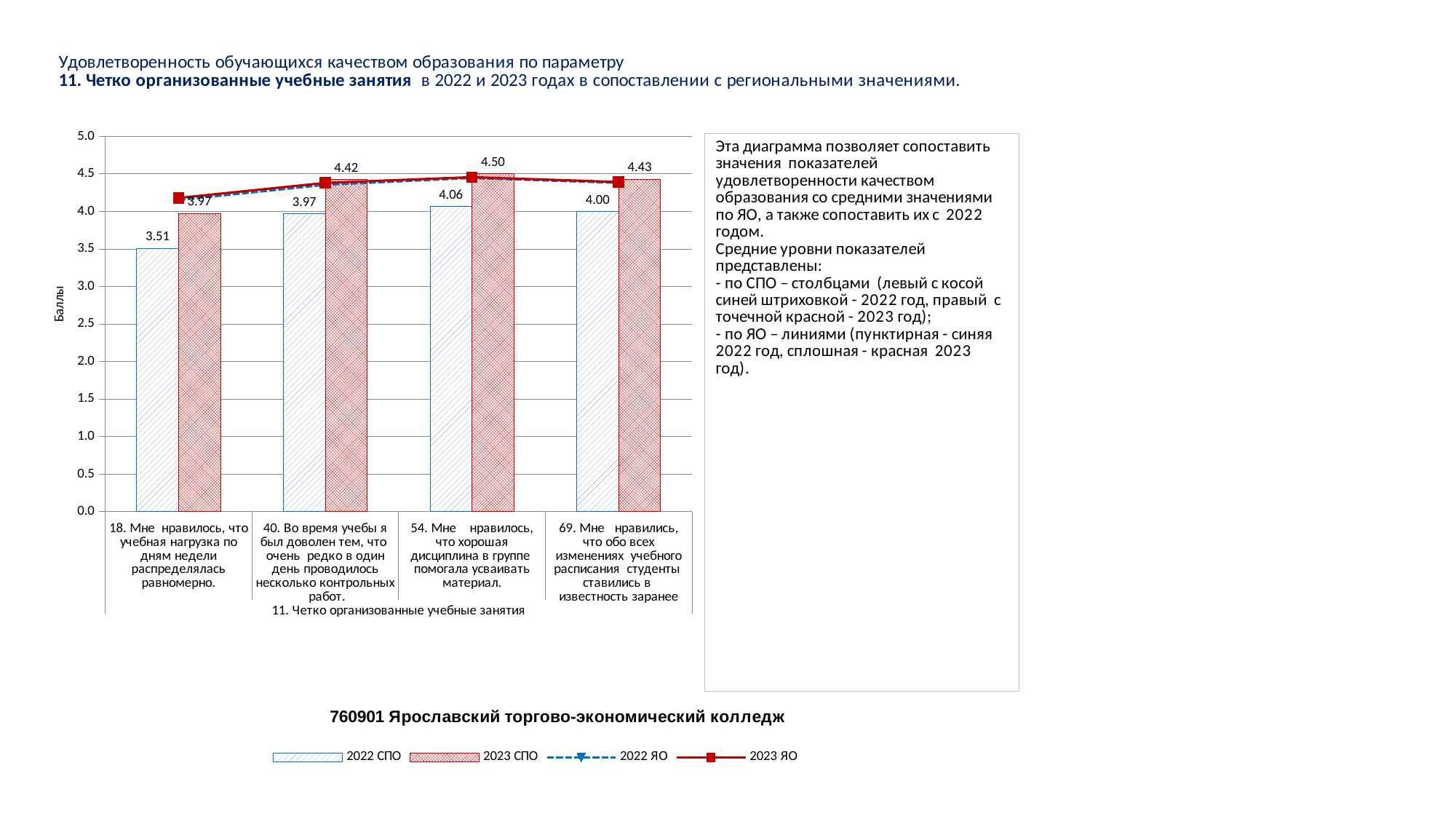
Which category has the lowest 2022 СПО value? 18. Мне нравилось, что учебная нагрузка по дням недели распределялась равномерно. How many series does the legend list? 4 Which is larger for category "40. Во время учебы я был доволен тем, что очень редко в один день проводилось несколько контрольных работ.": the 2022 СПО value or the 2023 СПО value? 2023 СПО What is the difference between the 2023 СПО and 2022 СПО values for category "18. Мне нравилось, что учебная нагрузка по дням недели распределялась равномерно."? 0.46 What is the 2022 СПО value for category "40. Во время учебы я был доволен тем, что очень редко в один день проводилось несколько контрольных работ."? 3.97 Is the 2023 ЯО value for category "18. Мне нравилось, что учебная нагрузка по дням недели распределялась равномерно." greater or less than 4.0? greater What is the 2022 СПО value for category "18. Мне нравилось, что учебная нагрузка по дням недели распределялась равномерно."? 3.51 Which category has the highest 2023 СПО value? 54. Мне нравилось, что хорошая дисциплина в группе помогала усваивать материал. What is the label of the vertical axis? Баллы What is the 2023 СПО value for category "54. Мне нравилось, что хорошая дисциплина в группе помогала усваивать материал."? 4.50 What is the 2023 СПО value for category "69. Мне нравились, что обо всех изменениях учебного расписания студенты ставились в известность заранее"? 4.43 How many categories are shown on the x axis? 4